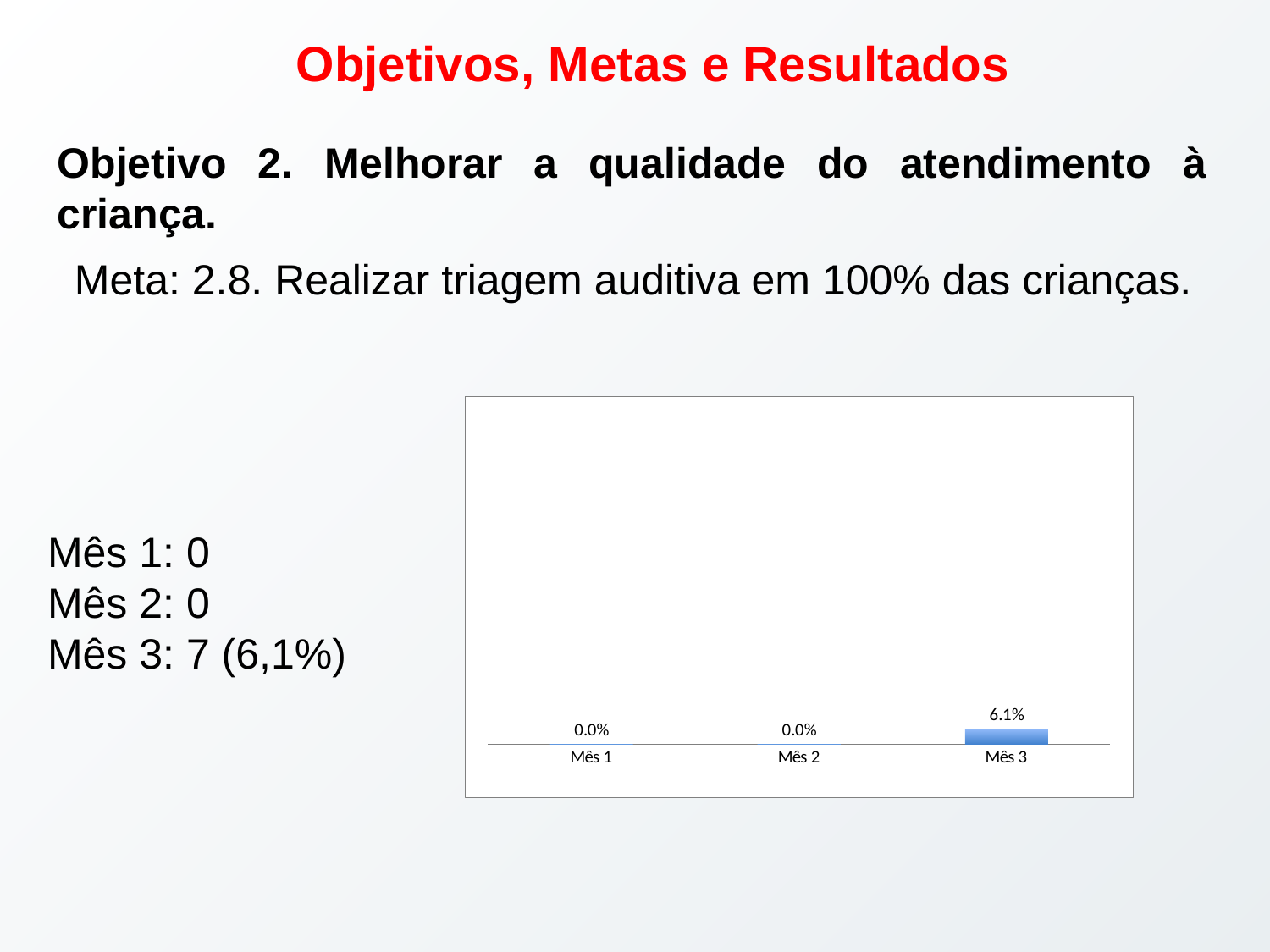
Do the values rise or fall from Mês 1 to Mês 3? Rise Which is larger, the value for Mês 3 or the value for Mês 1? Mês 3 What is the value for Mês 3 in the chart? 6.1% What is the value for Mês 2 in the chart? 0.0% What kind of chart is shown on the slide? Bar chart What is the value for Mês 1 in the chart? 0.0% How many categories are shown on the x axis of the chart? 3 What colour is the bar for Mês 3? Blue Which category has the highest value in the chart? Mês 3 What is the label of the last category on the x axis? Mês 3 What is the difference between the values for Mês 3 and Mês 2? 6.1%